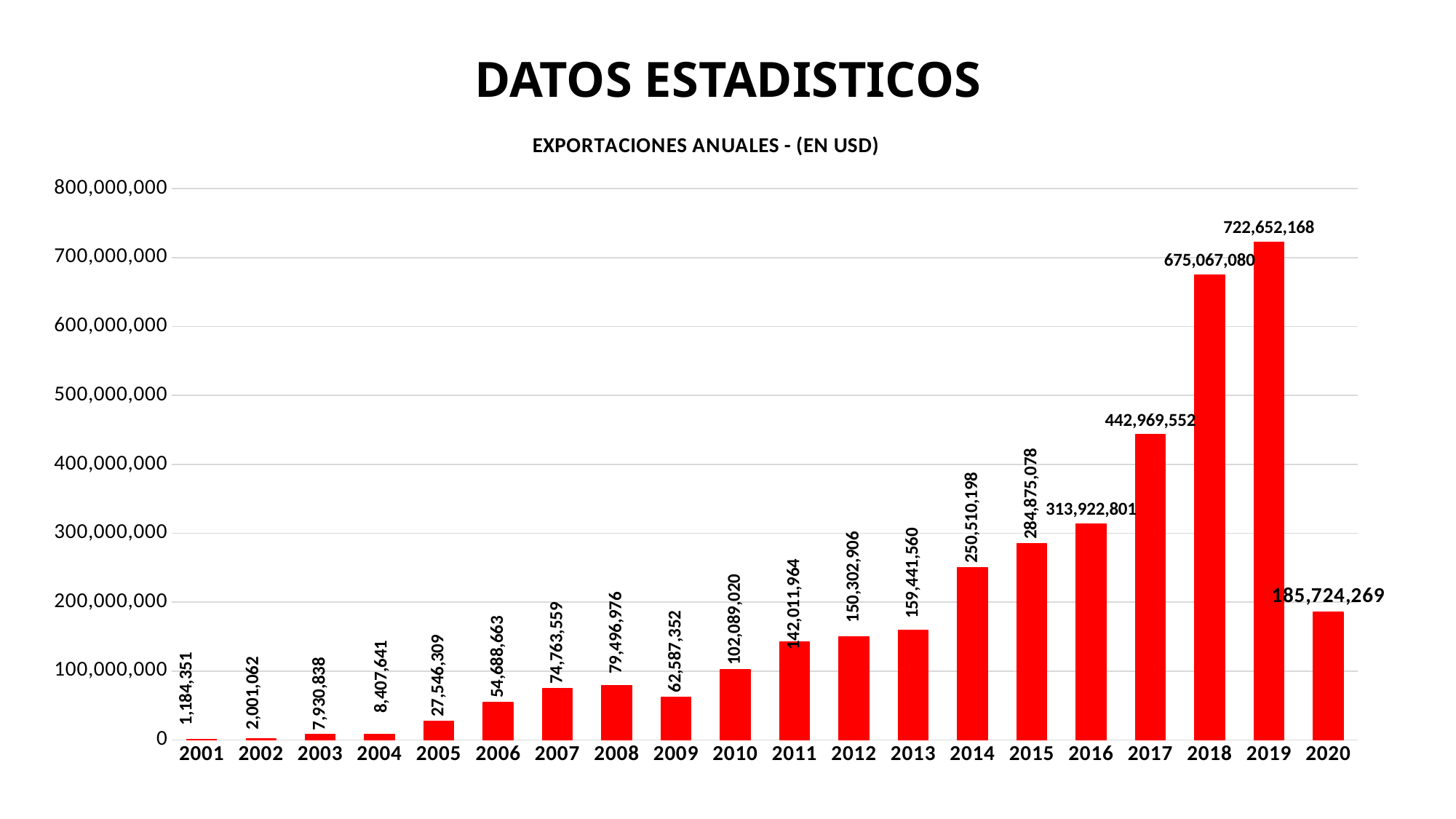
What is the title of the chart below the slide heading? EXPORTACIONES ANUALES - (EN USD) How many years are shown on the x axis of the chart? 20 Which is larger, the value for 2009 or the value for 2008? 2008 What is the difference between the values for 2008 and 2007? 4,733,417 Which year has the highest value in the chart? 2019 Which year has the lowest value in the chart? 2001 What is the value for 2020 in the chart? 185,724,269 What is the value for 2010 in the chart? 102,089,020 What kind of chart is shown on the slide? Bar chart Is the value for 2017 greater or less than 400,000,000? greater What is the value for 2019 in the chart? 722,652,168 What is the difference between the values for 2019 and 2018? 47,585,088